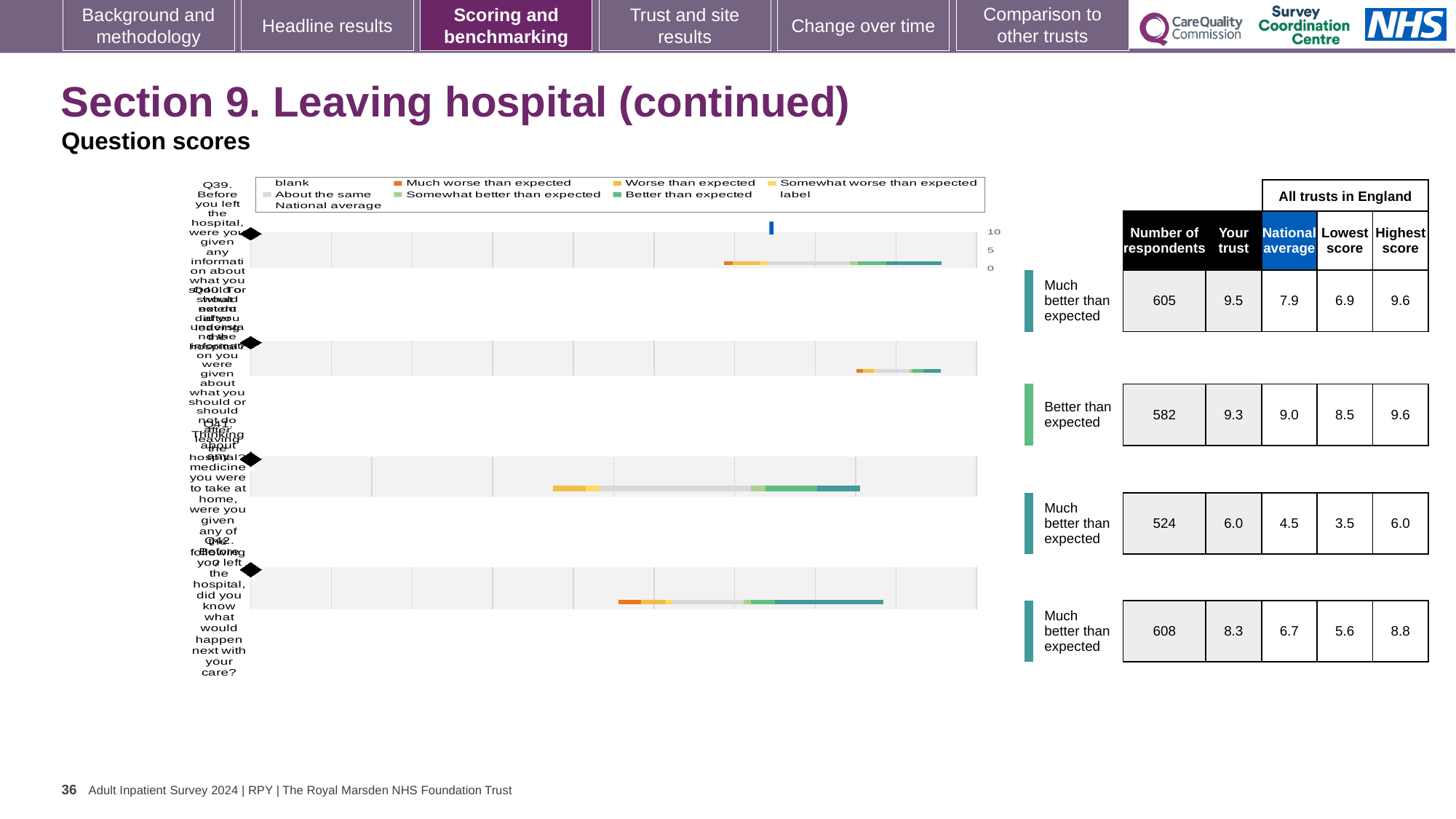
What is the difference between the trust score and the national average for Q41? 1.5 Which question has the lowest 'Your trust' score? Q41 How many respondents answered Q41? 524 What kind of chart is shown on the slide? bar chart What is the highest score across all trusts in England for Q42? 8.8 What is the national average score for Q40? 9.0 How many question rows (Q39 to Q42) are plotted in the chart? 4 Is the trust score for Q40 higher or lower than the national average for Q40? higher What benchmark category is shown for Q40? Better than expected What is the difference between the highest and lowest scores across all trusts for Q39? 2.7 Which question has the highest number of respondents? Q42 What is the 'Your trust' score for Q39 (Before you left the hospital, were you given any information about what you should or should not do after leaving)? 9.5